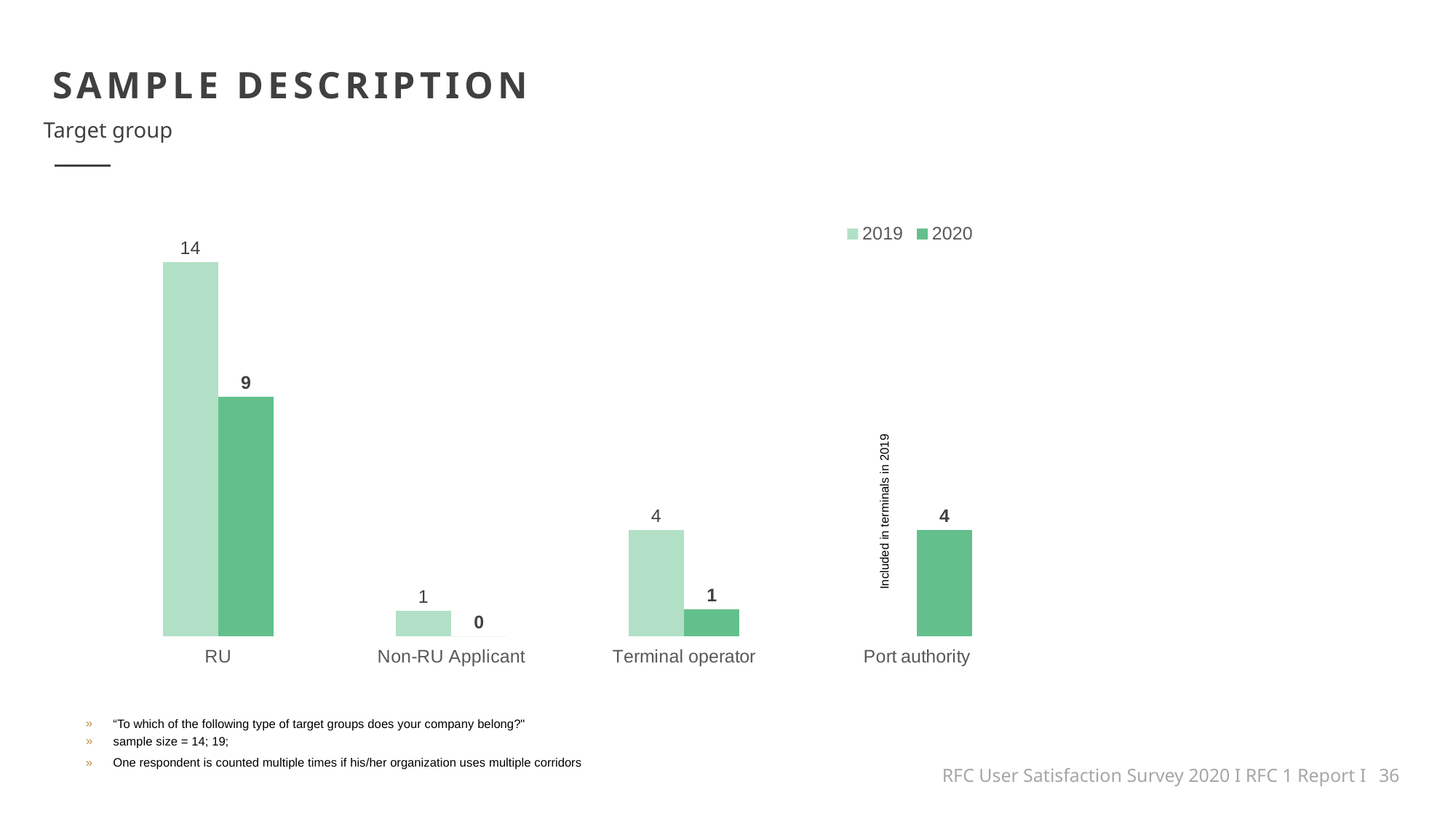
What is the difference between the 2019 and 2020 values for RU? 5 What is the 2020 value for RU? 9 What is the 2020 value for Non-RU Applicant? 0 How many categories are shown on the x axis? 4 What is the 2019 value for RU? 14 How many series does the legend list? 2 What type of chart is shown on the slide? Bar chart What is the 2020 value for Port authority? 4 Which category has the highest 2020 value? RU Which category has the lowest 2019 value among those with a 2019 bar? Non-RU Applicant Which is larger for Terminal operator, the 2019 value or the 2020 value? 2019 What is the 2019 value for Terminal operator? 4